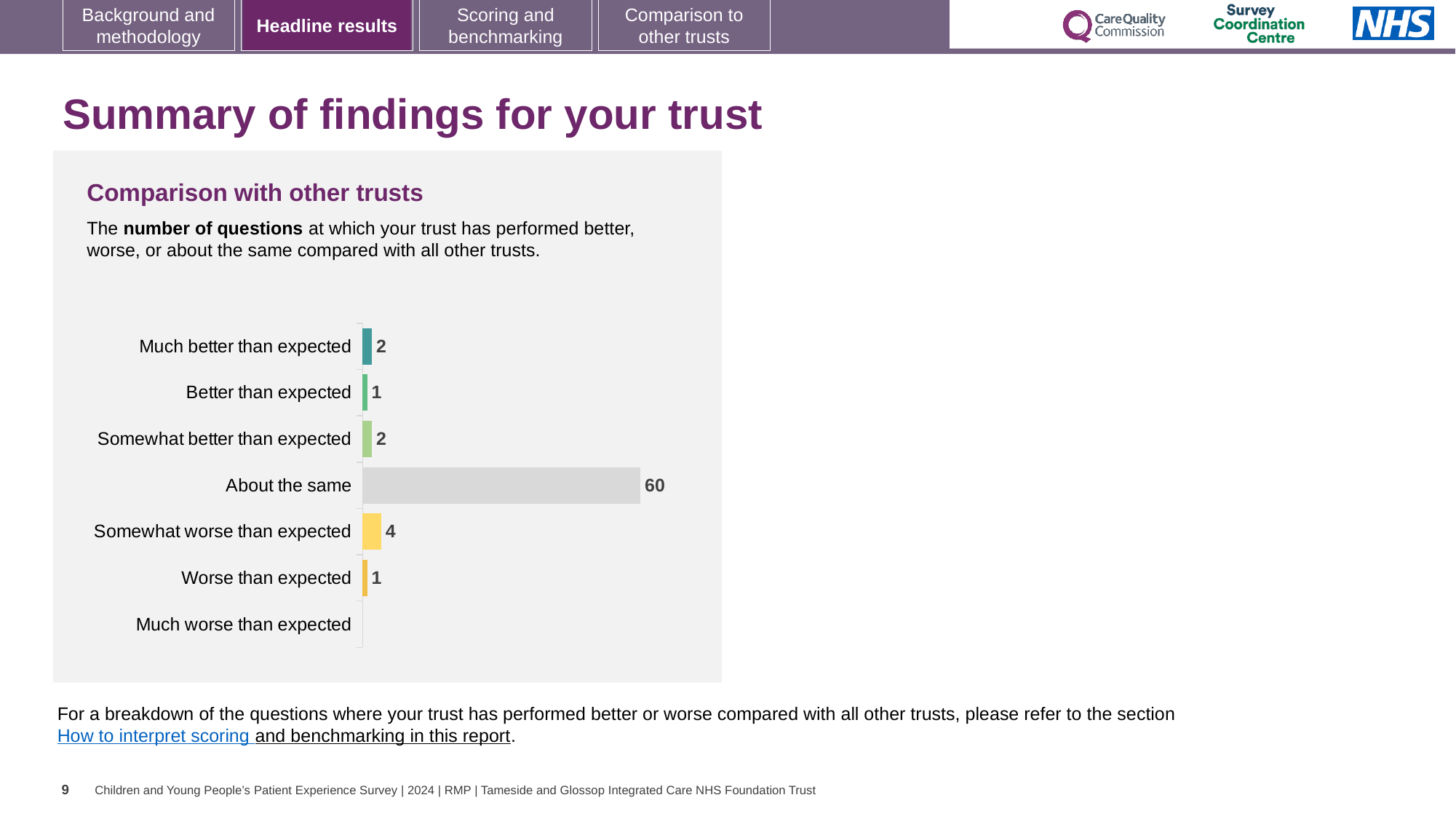
What is the value for 'Somewhat worse than expected'? 4 What kind of chart is shown on the slide? Bar chart What is the difference between 'Somewhat worse than expected' and 'Somewhat better than expected'? 2 Which category has no bar shown (zero questions)? Much worse than expected What is the value for 'Worse than expected'? 1 What is the difference between the values for 'About the same' and 'Somewhat worse than expected'? 56 How many questions are in the 'About the same' category? 60 Which is larger: the value for 'Somewhat worse than expected' or 'Much better than expected'? Somewhat worse than expected Which category has the highest number of questions? About the same What is the value for 'Much better than expected'? 2 What is the title of the chart? Comparison with other trusts How many categories are shown on the chart? 7